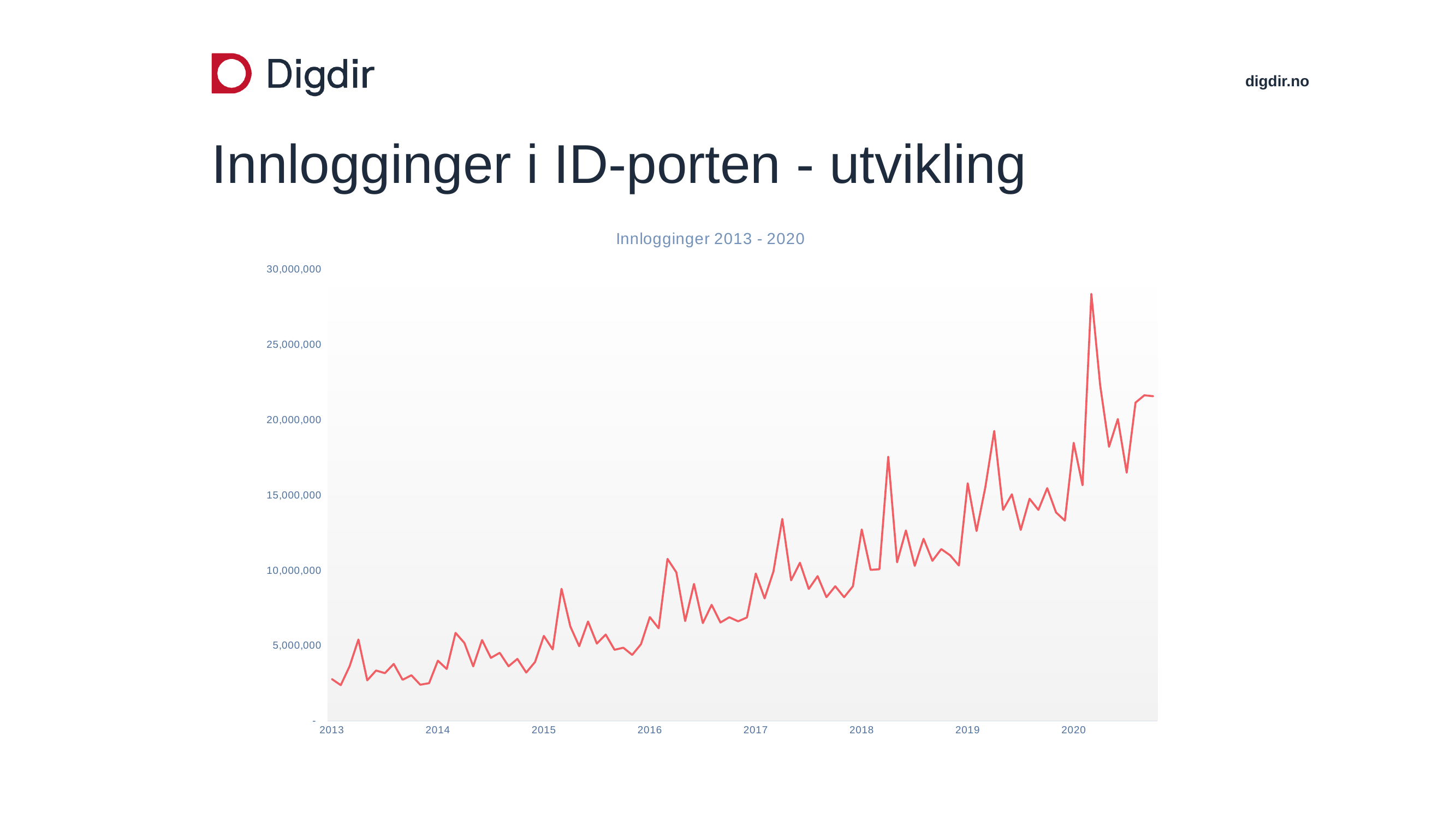
In which year does the line reach its highest point? 2020 Do the values generally rise or fall from 2013 to 2020? rise What colour is the line in the chart? red What is the title of the chart? Innlogginger 2013 - 2020 Is the value at the start of 2013 greater or less than 5,000,000? less Is the highest peak in 2019 greater or less than 15,000,000? greater Is the highest peak in 2017 greater or less than 15,000,000? less What kind of chart is shown on the slide? line chart How many year labels are shown on the x axis? 8